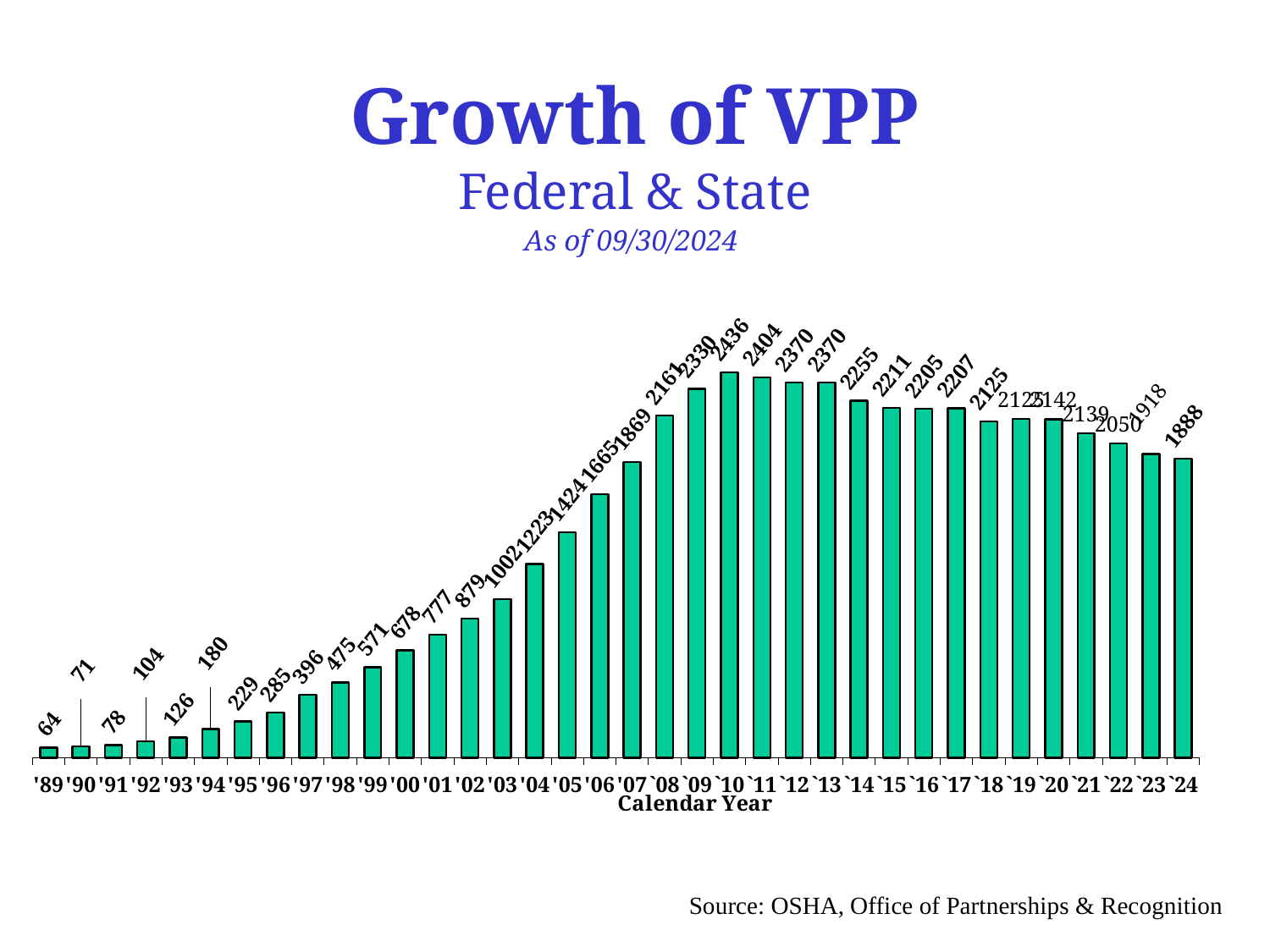
What kind of chart is shown on the slide? Bar chart What is the value for '00? 678 What is the value for '89? 64 Which year has the lowest value? '89 Do the values rise or fall from '89 to `10? Rise How many years (bars) are shown on the chart? 36 What is the value for `10? 2436 What is the difference between the values for `10 and `24? 548 What is the value for `24? 1888 Which is larger, the value for `08 or the value for `09? `09 What is the difference between the values for `23 and `24? 30 Which year has the highest value? `10